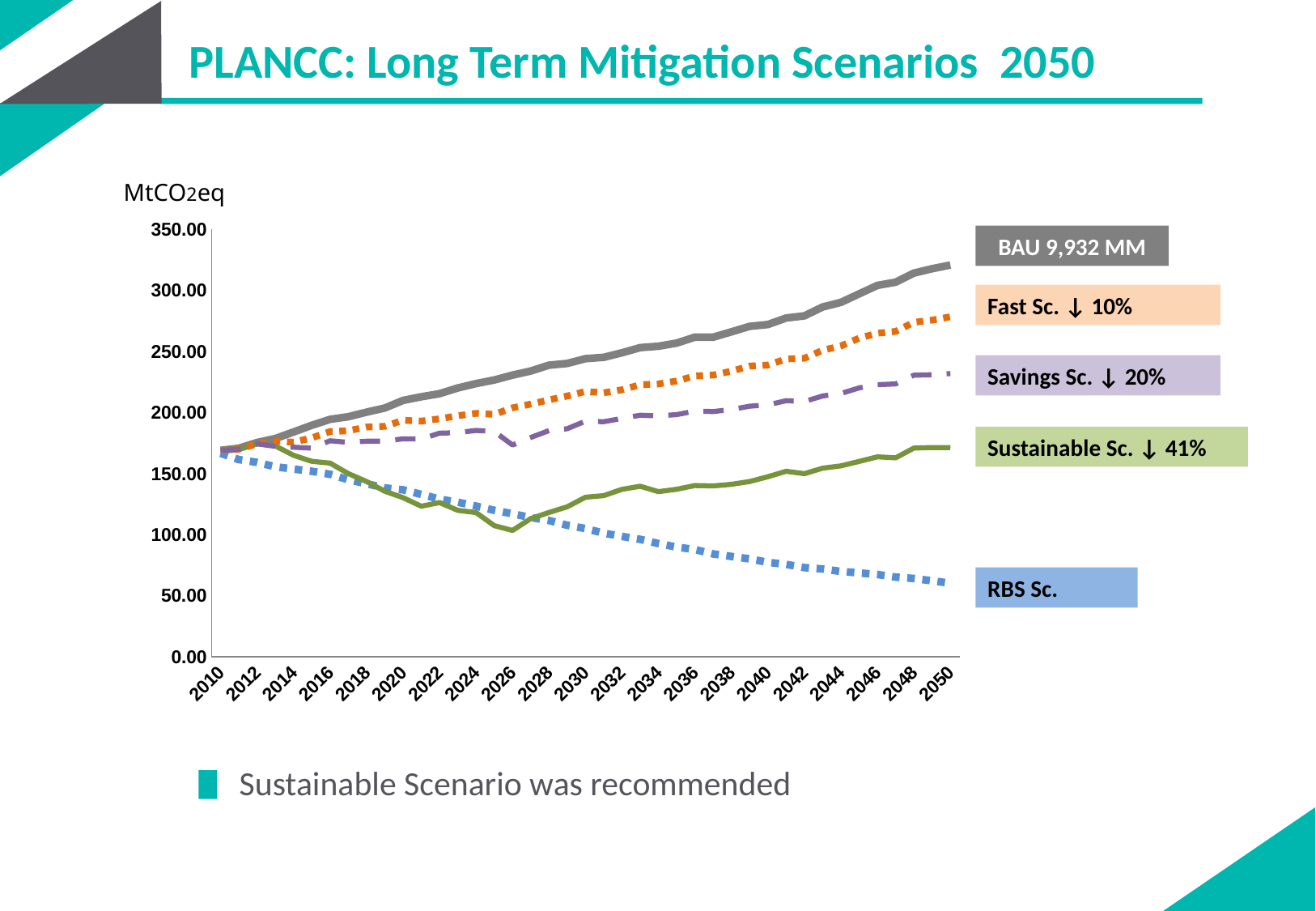
What unit is shown above the y axis of the chart? MtCO2eq Is the RBS Sc. value in 2050 greater or less than 100? less Is the Sustainable Sc. value in 2050 greater or less than 150? greater Does the BAU line rise or fall from 2010 to 2050? rise What reduction percentage is shown in the label for the Sustainable Sc.? 41% Is the BAU value in 2050 greater or less than 300? greater In 2050, which is higher: Fast Sc. or Savings Sc.? Fast Sc. How many scenario series are plotted on the chart? 5 Which scenario has the highest value in 2050? BAU What kind of chart is shown on the slide? line chart Which scenario has the lowest value in 2050? RBS Sc. Does the RBS Sc. line rise or fall from 2010 to 2050? fall